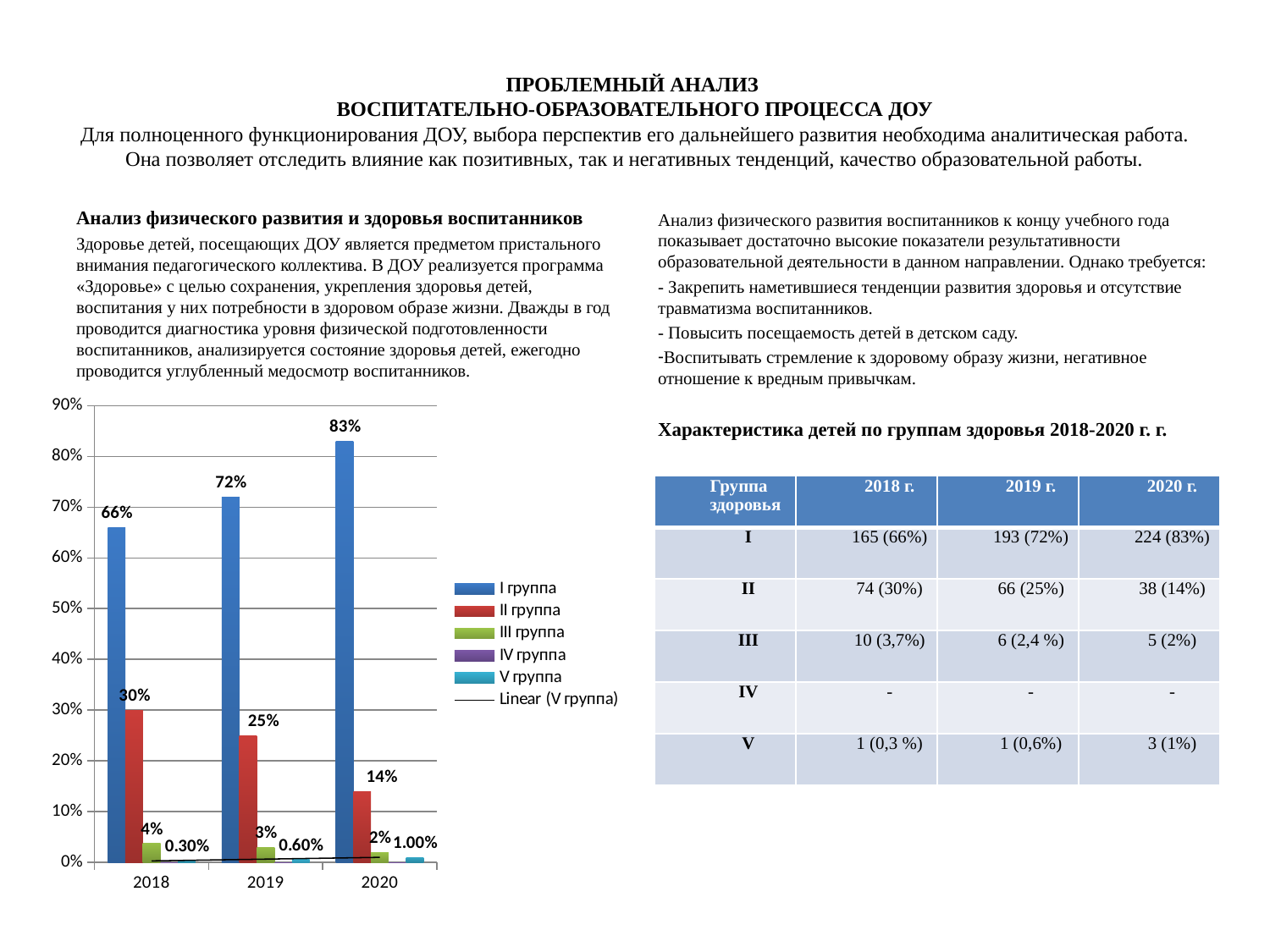
What is the value for I группа in 2020? 83% In which year is the value for II группа lowest? 2020 Which is larger: II группа in 2018 or II группа in 2020? II группа in 2018 What is the value for II группа in 2019? 25% How many entries does the chart legend list? 6 What kind of chart is shown on the slide? bar chart Does the value for I группа rise or fall from 2018 to 2020? rise In which year is the value for I группа highest? 2020 What is the value for III группа in 2018? 4% What is the value for V группа in 2018? 0.30% How many years are shown on the x axis of the chart? 3 What is the difference between the I группа values for 2020 and 2018? 17%